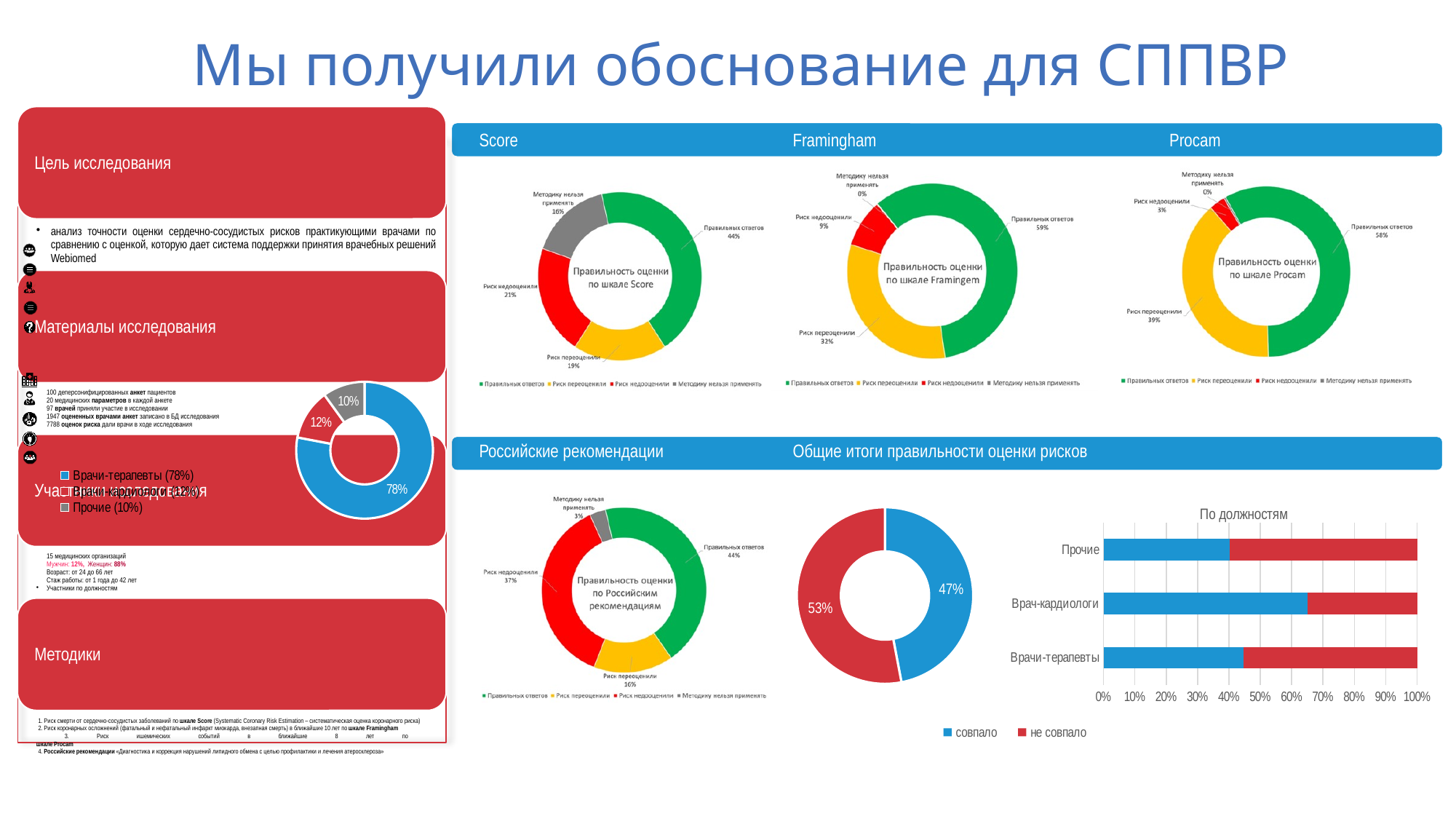
In the donut chart on the left panel, what share is labelled "Врачи-терапевты"? 78% In the Procam donut chart, what share is labelled "Риск недооценили"? 3% In the По должностям bar chart, is the "совпало" value for Врач-кардиологи greater or less than 60%? greater In the Procam donut chart, what is the difference between the "Правильных ответов" share and the "Риск переоценили" share? 19% In the Framingham donut chart, what share is labelled "Риск переоценили"? 32% In the Framingham donut chart, which category has the largest share? Правильных ответов In the Российские рекомендации donut chart, what share is labelled "Риск недооценили"? 37% In the Российские рекомендации donut chart, which is larger: "Риск переоценили" or "Риск недооценили"? Риск недооценили In the Общие итоги правильности оценки рисков donut chart, what share is "не совпало"? 53% In the Score donut chart, what share is labelled "Правильных ответов"? 44% In the Score donut chart, what share is labelled "Методику нельзя применять"? 16% How many categories does the По должностям bar chart show? 3